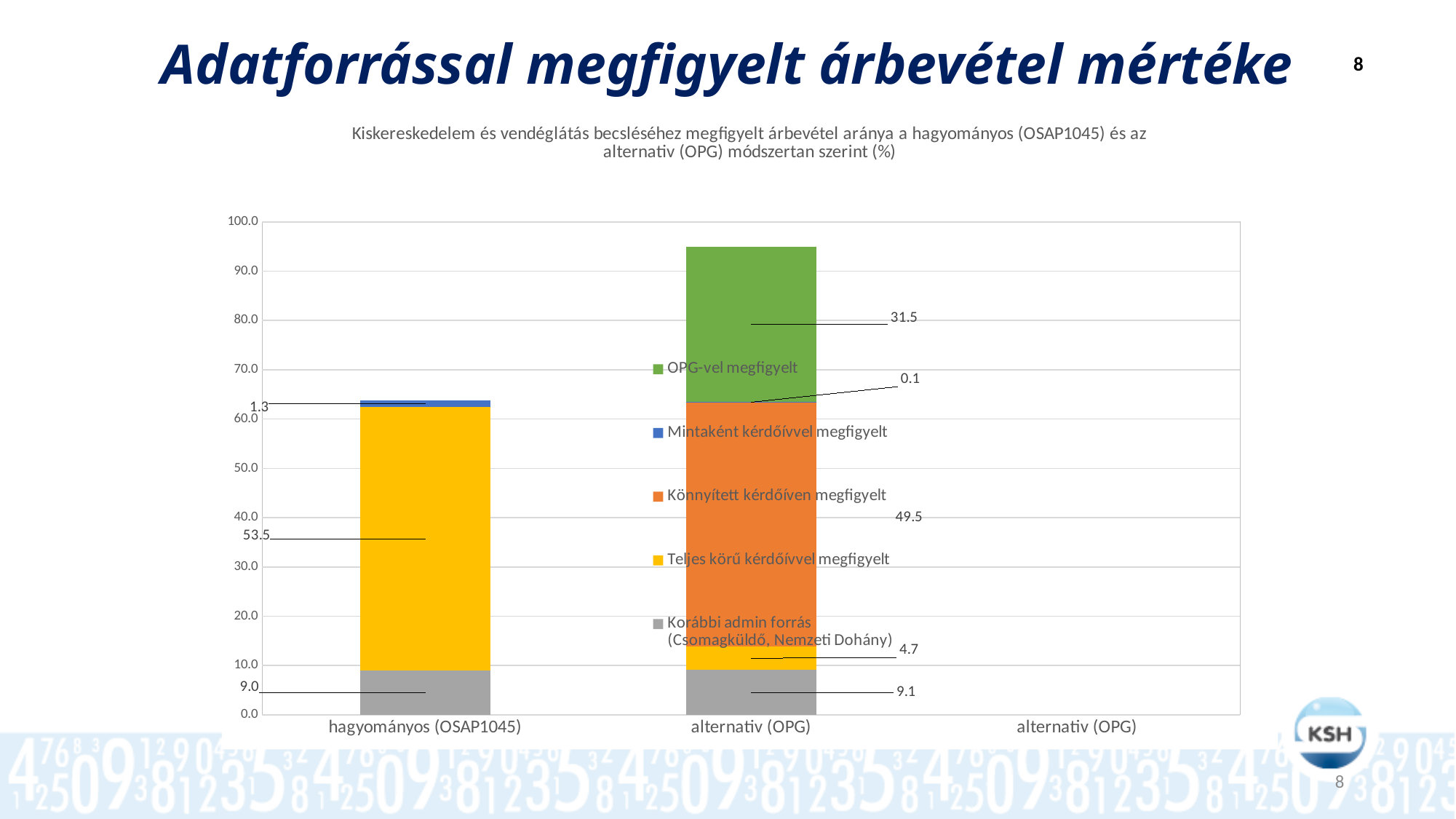
What is the total of the stacked bar for alternatív (OPG)? 94.9 What is the total of the stacked bar for hagyományos (OSAP1045)? 63.8 What is the value of 'OPG-vel megfigyelt' for alternatív (OPG)? 31.5 What is the value of 'Mintaként kérdőívvel megfigyelt' for alternatív (OPG)? 0.1 What is the difference between the 'Teljes körű kérdőívvel megfigyelt' values for hagyományos (OSAP1045) and alternatív (OPG)? 48.8 What is the value of 'Könnyített kérdőíven megfigyelt' for alternatív (OPG)? 49.5 What is the value of 'Teljes körű kérdőívvel megfigyelt' for hagyományos (OSAP1045)? 53.5 What colour represents 'OPG-vel megfigyelt' in the legend? green How many series does the legend list? 5 Which stacked bar is taller, hagyományos (OSAP1045) or alternatív (OPG)? alternatív (OPG) What is the value of 'Korábbi admin forrás (Csomagküldő, Nemzeti Dohány)' for hagyományos (OSAP1045)? 9.0 What kind of chart is shown on the slide? stacked bar chart